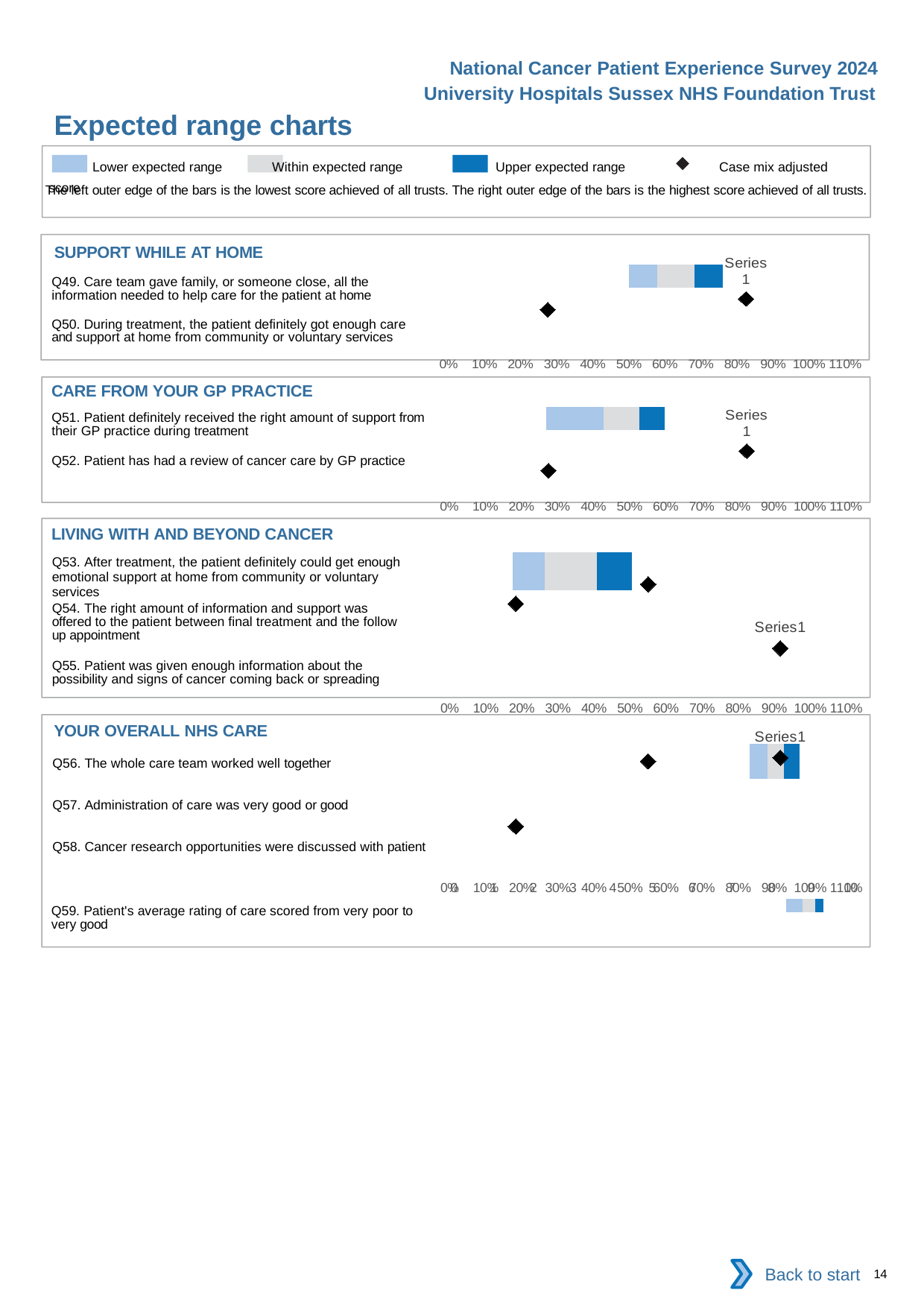
How many entries does the legend at the top of the slide list? 4 What kind of chart is used in the SUPPORT WHILE AT HOME section? bar chart How many questions are listed in the LIVING WITH AND BEYOND CANCER chart? 3 How many questions are listed in the CARE FROM YOUR GP PRACTICE chart? 2 In the CARE FROM YOUR GP PRACTICE chart, is the lowest-plotted diamond marker greater or less than 50%? less In the LIVING WITH AND BEYOND CANCER chart, is the rightmost diamond marker (next to the Series1 label) greater or less than 80%? greater How many questions are listed in the YOUR OVERALL NHS CARE chart? 4 What is the highest tick label on the x axis of the SUPPORT WHILE AT HOME chart? 110% In the LIVING WITH AND BEYOND CANCER chart, is the left edge of the expected range bar greater or less than 30%? less What are the four legend entries shown at the top of the slide? Lower expected range, Within expected range, Upper expected range, Case mix adjusted score